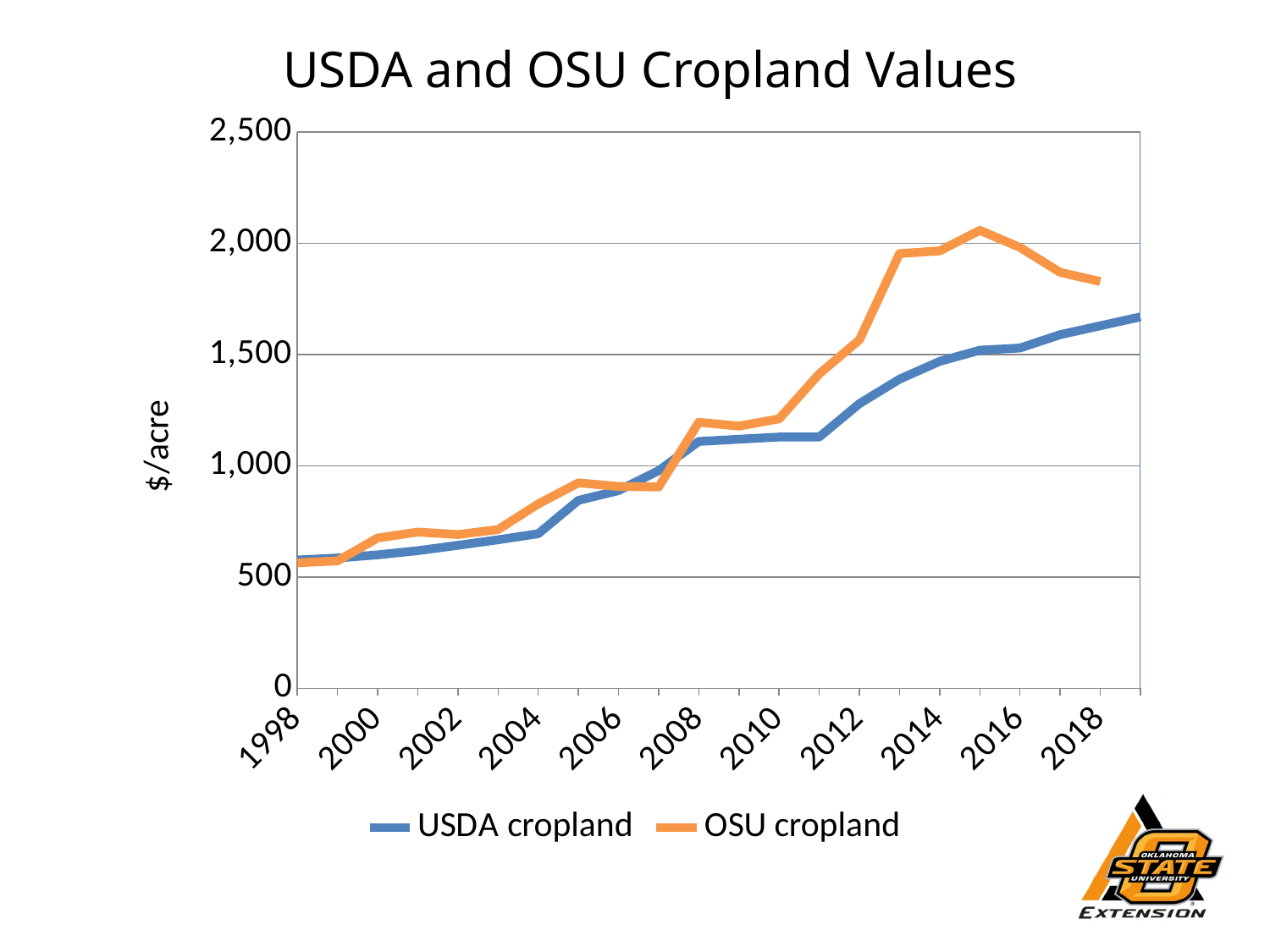
How many series does the legend list? 2 In 2014, which series has the higher value, USDA cropland or OSU cropland? OSU cropland Is the value for USDA cropland in 2006 greater or less than 1,000? less Is the value for USDA cropland in 2018 greater or less than 1,500? greater In which year does the OSU cropland series reach its peak? 2015 Which series reaches the highest value on the chart? OSU cropland What kind of chart is shown on the slide? line chart Does the USDA cropland series generally rise or fall from 1998 to 2018? rise Is the value for OSU cropland in 2018 greater or less than 2,000? less Does the OSU cropland series rise or fall between 2015 and 2018? fall What is the title of the chart? USDA and OSU Cropland Values What is the label on the vertical axis? $/acre